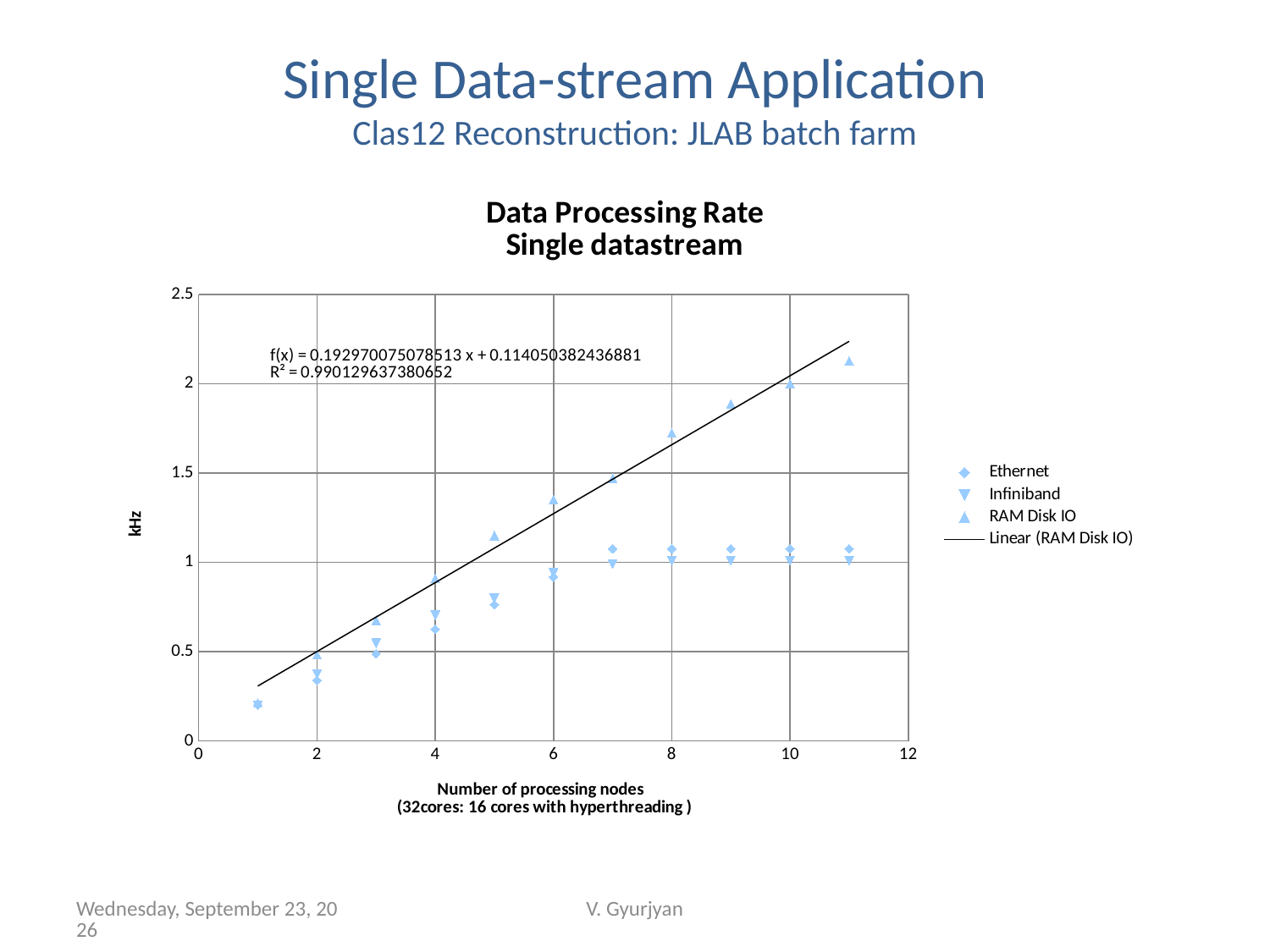
What kind of chart is shown on the slide? Scatter chart Does the RAM Disk IO rate rise or fall as the number of processing nodes increases? Rises How many processing-node values are plotted for each series? 11 At 11 processing nodes, which series has the higher rate: RAM Disk IO or Ethernet? RAM Disk IO Which series reaches the highest data processing rate on the chart? RAM Disk IO What is the title of the chart? Data Processing Rate Single datastream How many series does the legend list? 4 Is the RAM Disk IO value at 8 processing nodes greater or less than 1.5 kHz? greater Is the Ethernet value at 1 processing node greater or less than 0.5 kHz? less Is the RAM Disk IO value at 11 processing nodes greater or less than 2 kHz? greater What R² value is printed on the chart for the linear fit? R² = 0.990129637380652